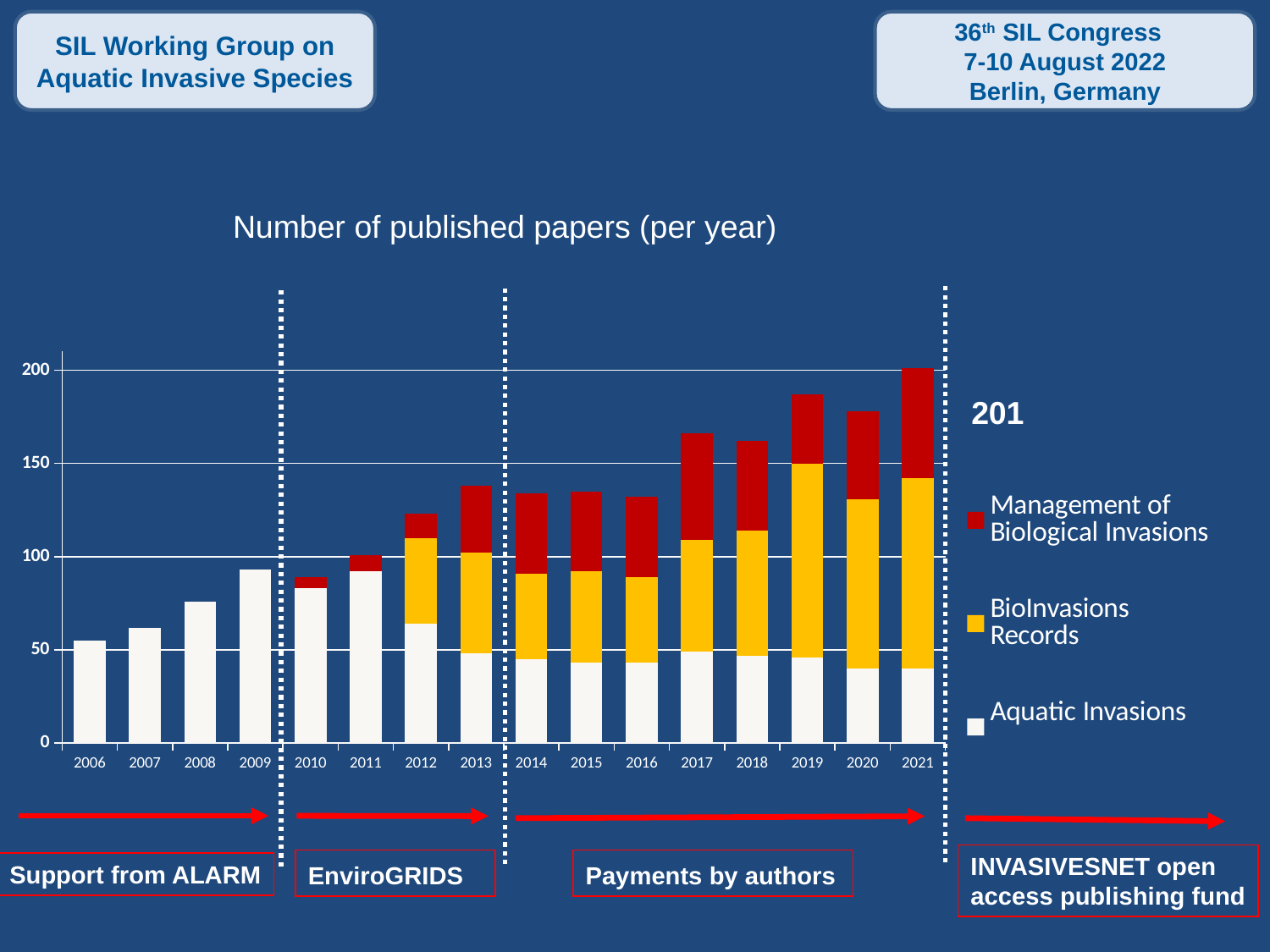
Which year has a larger total of published papers, 2016 or 2017? 2017 How many years are shown on the x axis of the chart? 16 How many series does the legend list? 3 What kind of chart is shown on the slide? bar chart Do the total numbers of published papers rise or fall from 2006 to 2009? rise Is the total number of published papers in 2019 greater or less than 150? greater Is the total number of published papers in 2006 greater or less than 100? less What is the title of the chart? Number of published papers (per year) What total number of published papers is labelled for 2021? 201 Which year has the lowest total number of published papers? 2006 Which year has the highest total number of published papers? 2021 Which is the first year in which the BioInvasions Records series appears in the chart? 2012